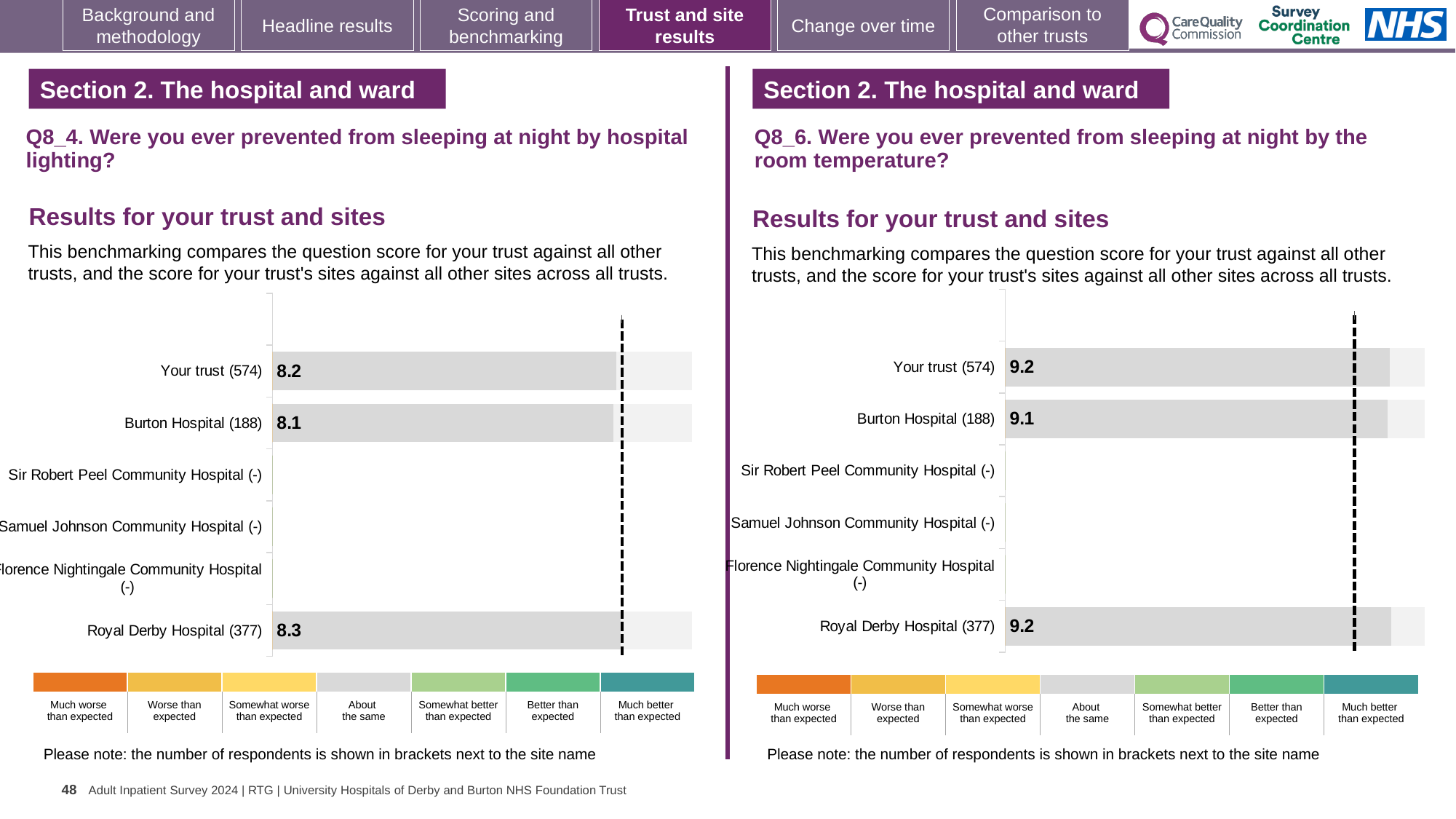
In the Q8_6 chart (room temperature), what is the score for Your trust (574)? 9.2 In the Q8_6 chart (room temperature), what is the difference between the scores for Your trust (574) and Burton Hospital (188)? 0.1 In the Q8_6 chart (room temperature), which has the lower score, Burton Hospital (188) or Royal Derby Hospital (377)? Burton Hospital (188) In the Q8_4 chart (hospital lighting), what is the score for Your trust (574)? 8.2 In the Q8_4 chart (hospital lighting), which site has the highest score? Royal Derby Hospital (377) In the Q8_6 chart (room temperature), what is the score for Royal Derby Hospital (377)? 9.2 In the Q8_4 chart (hospital lighting), what is the score for Burton Hospital (188)? 8.1 In the Q8_6 chart (room temperature), what is the score for Burton Hospital (188)? 9.1 In the Q8_4 chart (hospital lighting), what is the difference between the scores for Royal Derby Hospital (377) and Burton Hospital (188)? 0.2 How many site rows (including Your trust) are listed in the Q8_4 chart (hospital lighting)? 6 In the Q8_4 chart (hospital lighting), what is the score for Royal Derby Hospital (377)? 8.3 What kind of chart is used in the Q8_6 chart (room temperature)? Bar chart